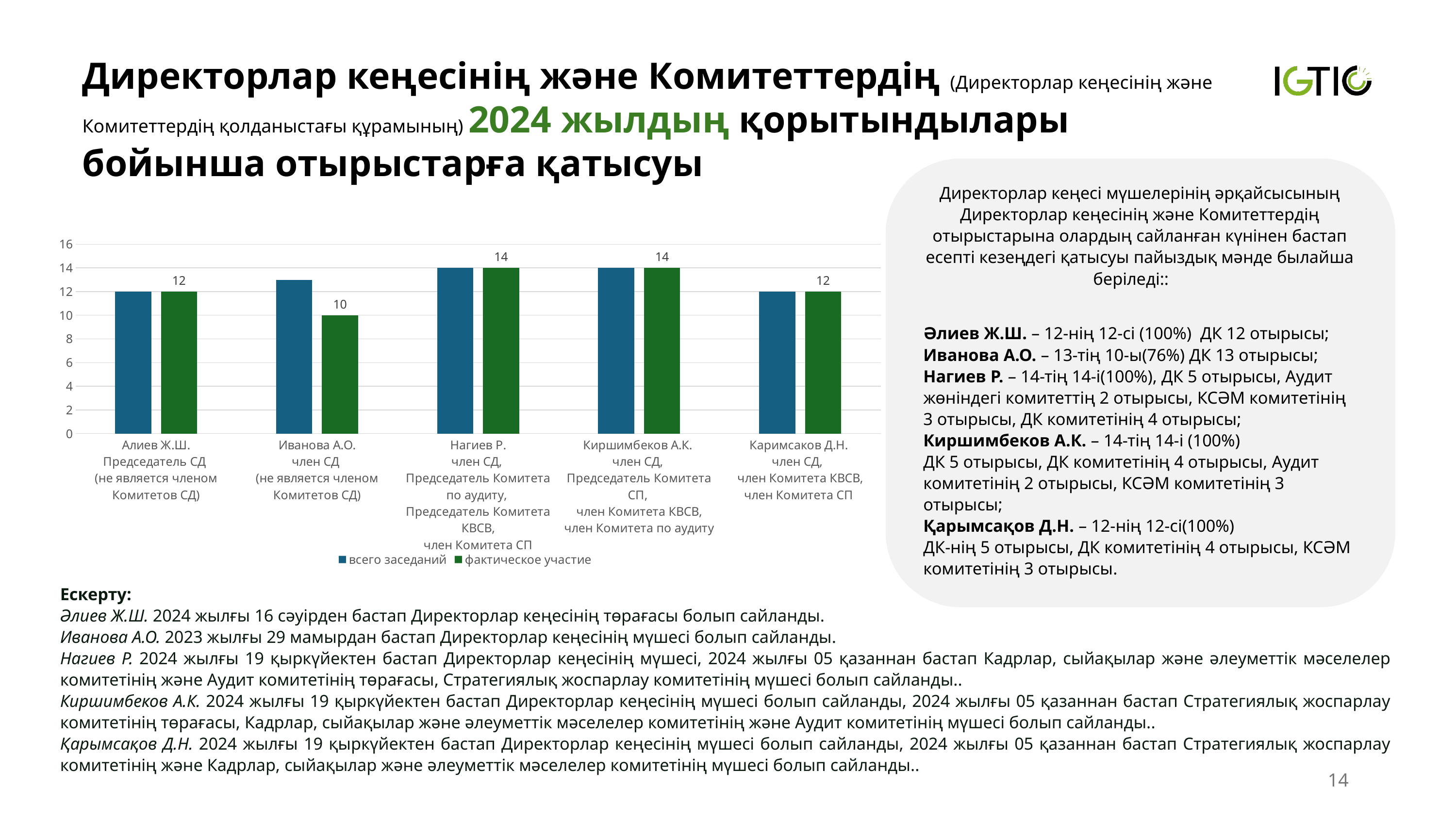
How many categories (board members) are shown on the x axis? 5 How many series does the legend list? 2 Is the value of всего заседаний for Иванова А.О. greater or less than 10? greater Which category has the lowest value for фактическое участие? Иванова А.О. What kind of chart is shown on the slide? bar chart What is the value of фактическое участие for Каримсаков Д.Н.? 12 What is the value of фактическое участие for Иванова А.О.? 10 Which is larger: the фактическое участие value for Нагиев Р. or for Каримсаков Д.Н.? Нагиев Р. What is the value of всего заседаний for Алиев Ж.Ш.? 12 What is the difference between the фактическое участие values for Алиев Ж.Ш. and Иванова А.О.? 2 What is the difference between the фактическое участие values for Киршимбеков А.К. and Иванова А.О.? 4 What is the value of фактическое участие for Нагиев Р.? 14